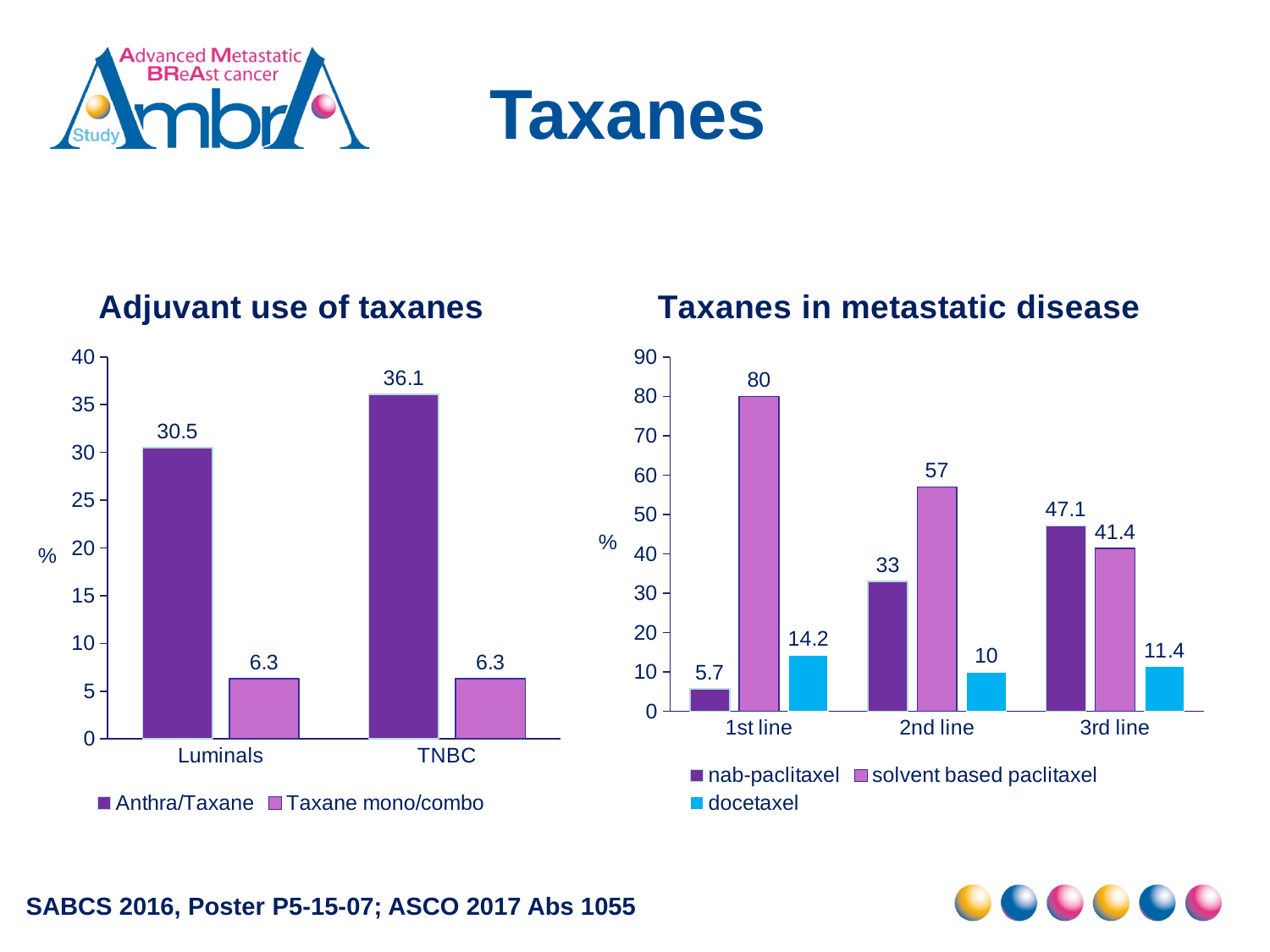
In the 'Taxanes in metastatic disease' chart, which is larger in 3rd line: nab-paclitaxel or solvent based paclitaxel? nab-paclitaxel In the 'Taxanes in metastatic disease' chart, what is the value for solvent based paclitaxel in 1st line? 80 In the 'Taxanes in metastatic disease' chart, how does the value for nab-paclitaxel change from 1st line to 3rd line? It rises In the 'Adjuvant use of taxanes' chart, what is the difference between Anthra/Taxane for TNBC and for Luminals? 5.6 In the 'Taxanes in metastatic disease' chart, what is the difference between solvent based paclitaxel and nab-paclitaxel in 2nd line? 24 In the 'Adjuvant use of taxanes' chart, what is the value for Taxane mono/combo in Luminals? 6.3 In the 'Taxanes in metastatic disease' chart, which line has the highest value for nab-paclitaxel? 3rd line What kind of chart is 'Taxanes in metastatic disease'? Bar chart In the 'Taxanes in metastatic disease' chart, what is the value for docetaxel in 3rd line? 11.4 In the 'Taxanes in metastatic disease' chart, which line has the lowest value for solvent based paclitaxel? 3rd line In the 'Adjuvant use of taxanes' chart, what is the value for Anthra/Taxane in TNBC? 36.1 In the 'Adjuvant use of taxanes' chart, how many series does the legend list? 2